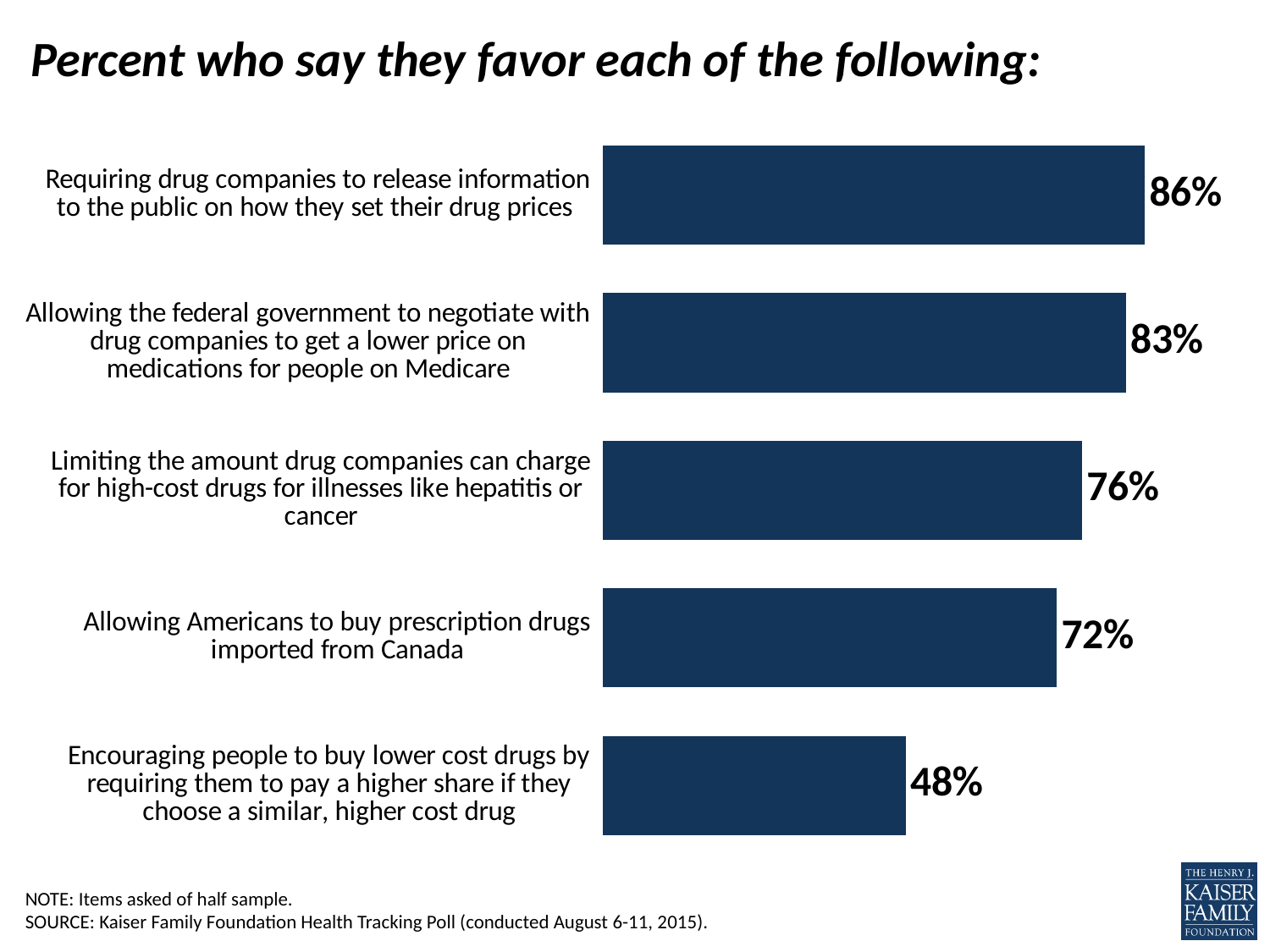
What percent say they favor encouraging people to buy lower cost drugs by requiring them to pay a higher share if they choose a similar, higher cost drug? 48% How many policies are shown in the chart? 5 What kind of chart is shown on the slide? Bar chart Which policy has the lowest percent in favor? Encouraging people to buy lower cost drugs by requiring them to pay a higher share if they choose a similar, higher cost drug What is the difference in percentage points between the share favoring requiring drug companies to release pricing information and the share favoring allowing Americans to buy prescription drugs imported from Canada? 14 What percent say they favor allowing Americans to buy prescription drugs imported from Canada? 72% Which has a higher percent in favor: limiting the amount drug companies can charge for high-cost drugs, or allowing Americans to buy prescription drugs imported from Canada? Limiting the amount drug companies can charge for high-cost drugs for illnesses like hepatitis or cancer What percent say they favor allowing the federal government to negotiate with drug companies to get a lower price on medications for people on Medicare? 83% Which policy has the highest percent in favor? Requiring drug companies to release information to the public on how they set their drug prices What is the title of the chart? Percent who say they favor each of the following: What percent say they favor limiting the amount drug companies can charge for high-cost drugs for illnesses like hepatitis or cancer? 76% What percent say they favor requiring drug companies to release information to the public on how they set their drug prices? 86%